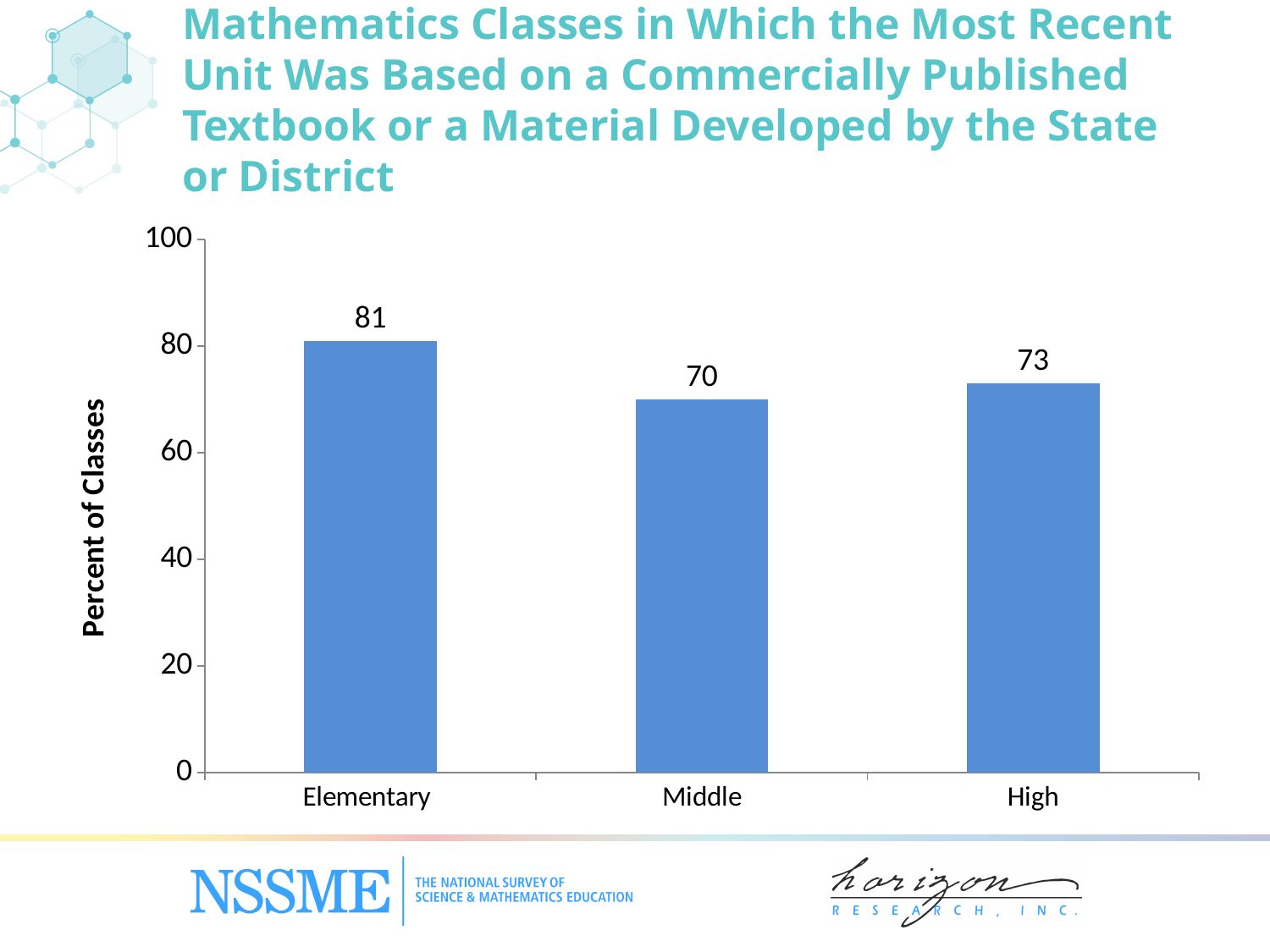
What is the value for Elementary? 81 Which category has the highest value? Elementary How many categories are shown on the x axis? 3 What is the difference between the values for High and Middle? 3 What kind of chart is shown on the slide? bar chart Is the value for Elementary greater or less than 80? greater What is the label of the y axis? Percent of Classes What is the value for High? 73 Which category has the lowest value? Middle What is the difference between the values for Elementary and Middle? 11 What is the value for Middle? 70 Which is larger, the value for Elementary or the value for High? Elementary